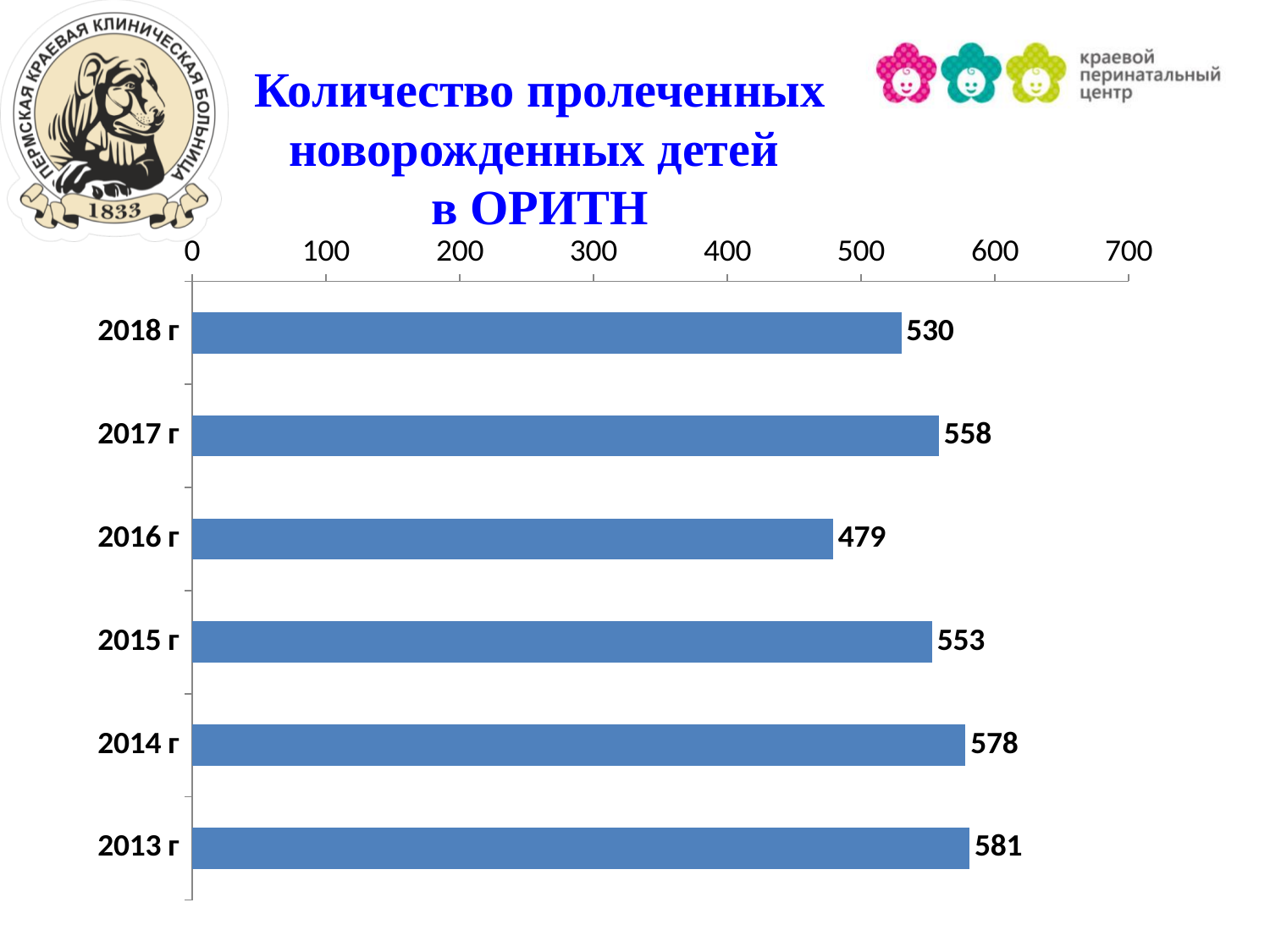
Which is larger, the value for 2017 г or the value for 2015 г? 2017 г What kind of chart is shown on the slide? bar chart What is the value for 2014 г? 578 Is the value for 2016 г greater or less than 500? less Which year has the lowest value? 2016 г What is the difference between the values for 2017 г and 2016 г? 79 What is the value for 2018 г? 530 Which year has the highest value? 2013 г How many years are shown in the chart? 6 What is the title of the chart? Количество пролеченных новорожденных детей в ОРИТН What is the value for 2016 г? 479 What is the difference between the values for 2013 г and 2018 г? 51